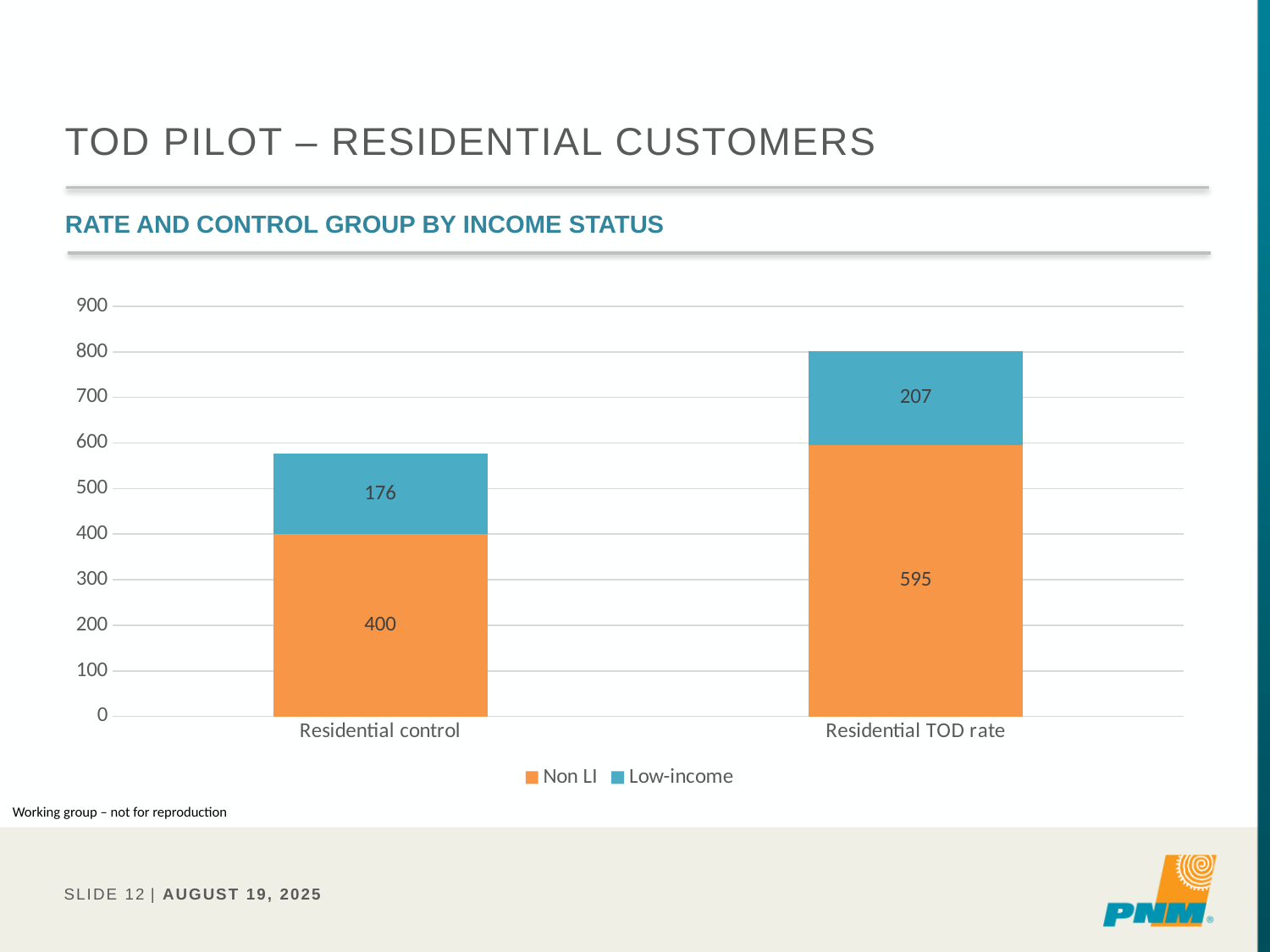
Which category has the higher Low-income value, Residential control or Residential TOD rate? Residential TOD rate What is the total of the stacked bar for Residential TOD rate? 802 What is the Low-income value for Residential control? 176 What is the Non LI value for Residential control? 400 What is the Non LI value for Residential TOD rate? 595 What is the difference between the Non LI values for Residential TOD rate and Residential control? 195 What kind of chart is shown on the slide? Stacked bar chart What is the Low-income value for Residential TOD rate? 207 What is the total of the stacked bar for Residential control? 576 How many categories are shown on the x axis? 2 Which category has the highest Non LI value? Residential TOD rate How many series does the legend list? 2